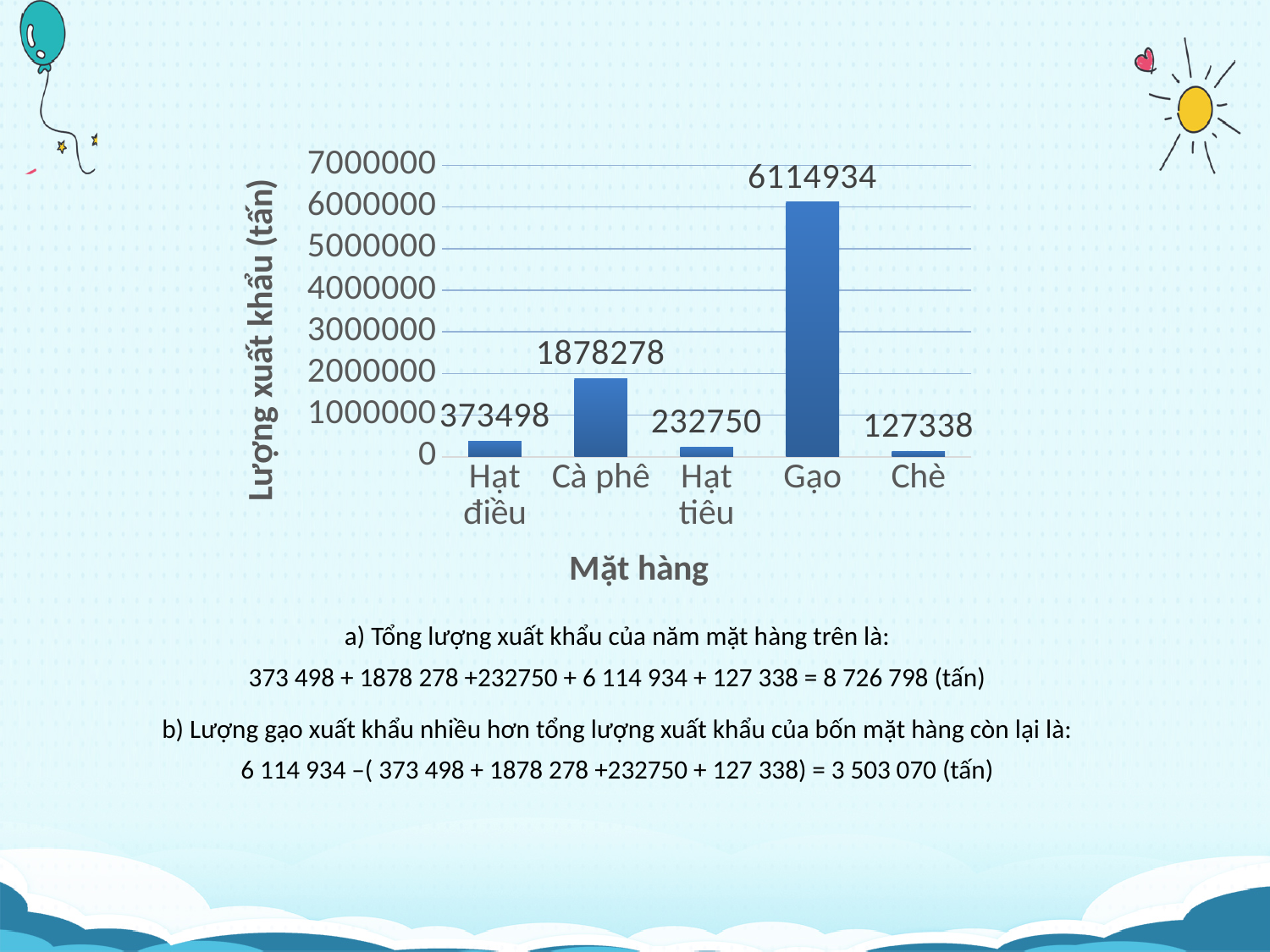
What is the export volume for Gạo? 6114934 What type of chart is shown on the slide? bar chart Which item has the highest export volume? Gạo Which item has the lowest export volume? Chè What is the export volume for Hạt tiêu? 232750 What is the difference between the export volumes of Gạo and Cà phê? 4236656 What is the difference between the export volumes of Hạt điều and Hạt tiêu? 140748 How many items are shown on the x axis? 5 Is the value for Cà phê greater or less than 2000000? less What is the export volume for Cà phê? 1878278 Which has a larger export volume, Hạt điều or Hạt tiêu? Hạt điều What is the export volume for Chè? 127338